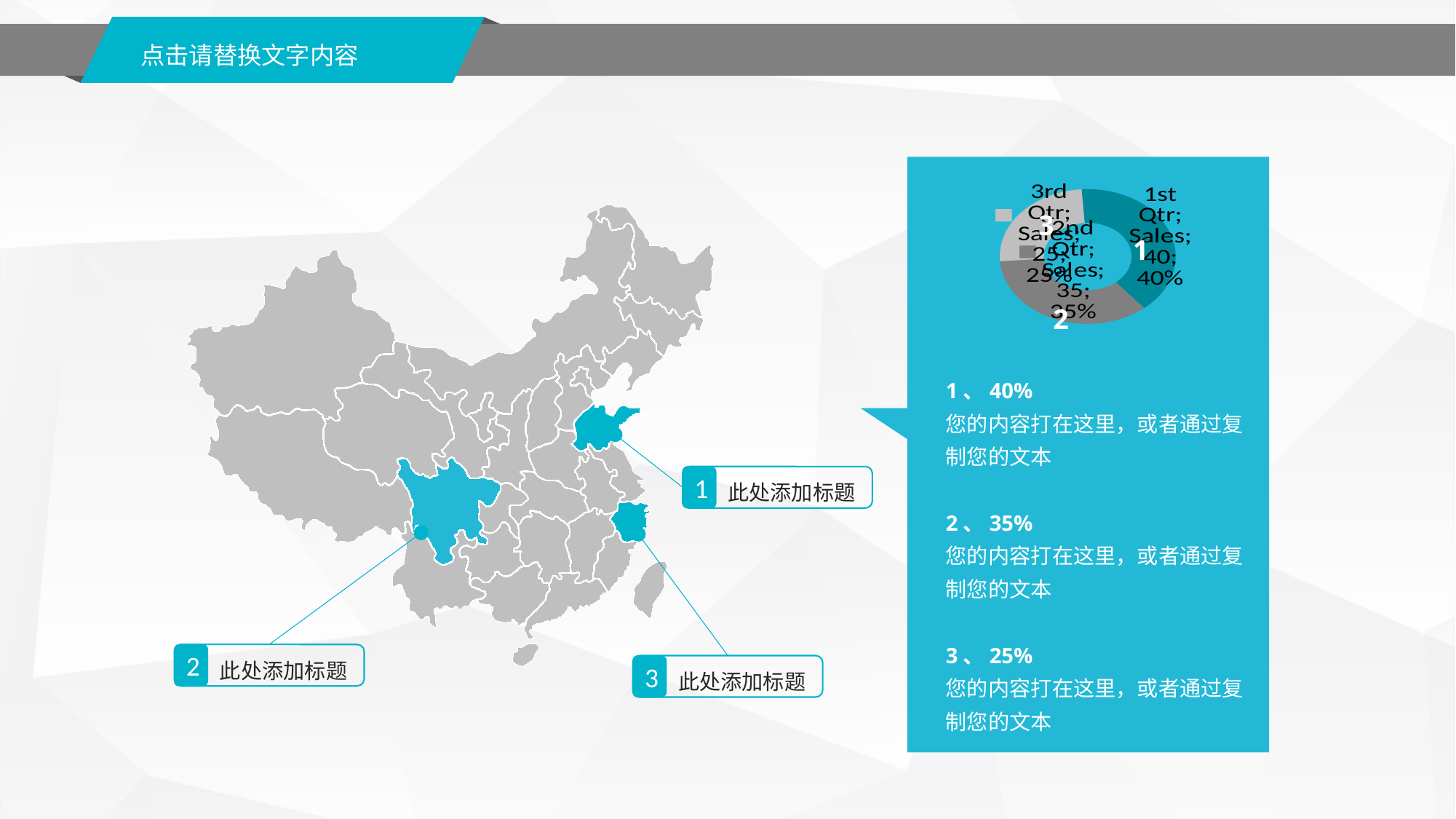
What is the value for 1st Qtr in the doughnut chart? 40 What share of the doughnut chart does 1st Qtr represent? 40% What is the name of the data series shown in the doughnut chart? Sales Which quarter has the largest slice in the doughnut chart? 1st Qtr What share of the doughnut chart does 3rd Qtr represent? 25% What is the difference between the 1st Qtr and 3rd Qtr values in the doughnut chart? 15 Which is larger in the doughnut chart, 2nd Qtr or 3rd Qtr? 2nd Qtr Which quarter has the smallest slice in the doughnut chart? 3rd Qtr How many slices does the doughnut chart have? 3 What is the value for 3rd Qtr in the doughnut chart? 25 What kind of chart is shown on the slide? doughnut chart What is the value for 2nd Qtr in the doughnut chart? 35